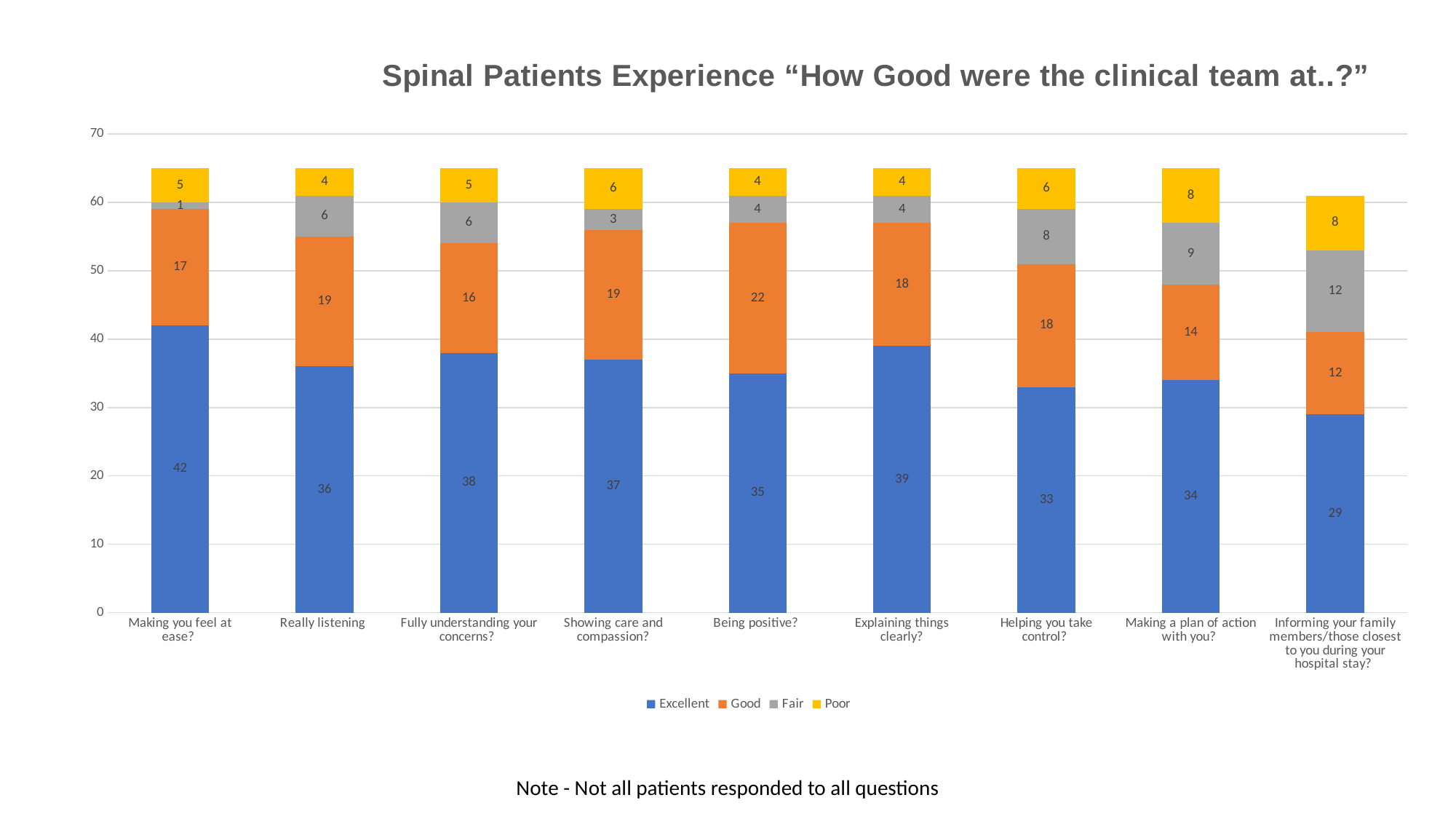
What is the Good value for "Being positive?"? 22 Which category has the lowest Excellent value? Informing your family members/those closest to you during your hospital stay? What is the Fair value for "Making a plan of action with you?"? 9 What is the Excellent value for "Making you feel at ease?"? 42 What kind of chart is shown on the slide? Stacked bar chart How many series does the legend list? 4 Which category has the highest Excellent value? Making you feel at ease? How many categories are shown on the x axis? 9 What is the total of the stacked bar for "Helping you take control?"? 65 What is the Poor value for "Showing care and compassion?"? 6 Which is larger: the Good value for "Really listening" or the Good value for "Fully understanding your concerns?"? Really listening What is the difference between the Excellent values for "Making you feel at ease?" and "Really listening"? 6